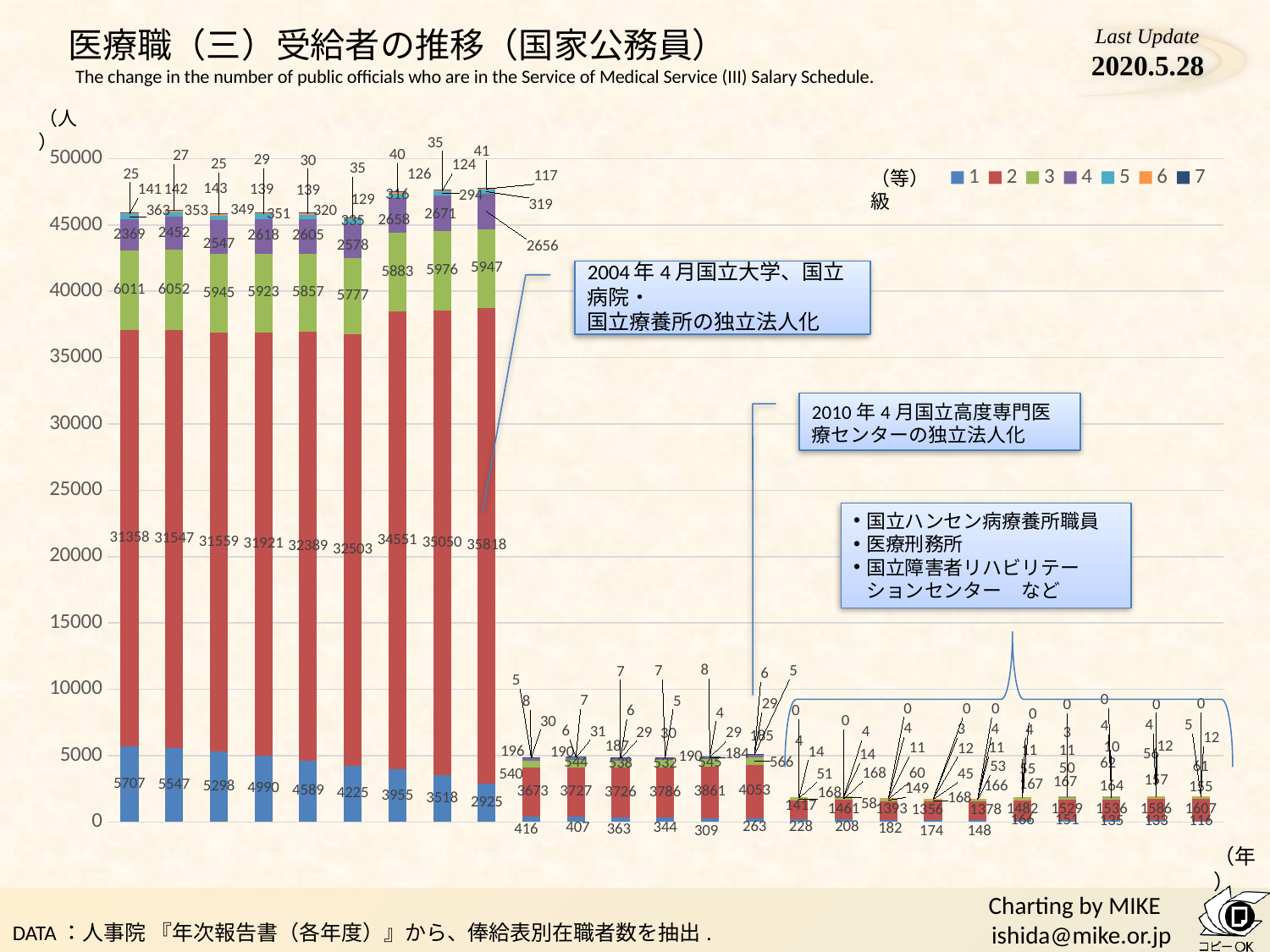
In the leftmost bar, what is the value labeled for series 2 (red)? 31358 What is the difference between the series 3 (green) values of the first two bars, 6052 and 6011? 41 What is the largest value labeled for series 3 (green) in the chart? 6052 What is the largest value labeled for series 2 (red) in the chart? 35818 Do the series 1 (blue) values rise or fall from left to right along the x axis? fall What is the smallest value labeled for series 1 (blue) in the chart? 116 Is the total height of the leftmost bar greater or less than 45000? greater How many series does the legend list? 7 What kind of chart is shown on the slide? bar chart In the leftmost bar, which is larger: the series 1 (blue) value or the series 3 (green) value? series 3 (green) How many bars are plotted in the chart? 25 In the leftmost bar, what is the value labeled for series 1 (blue)? 5707